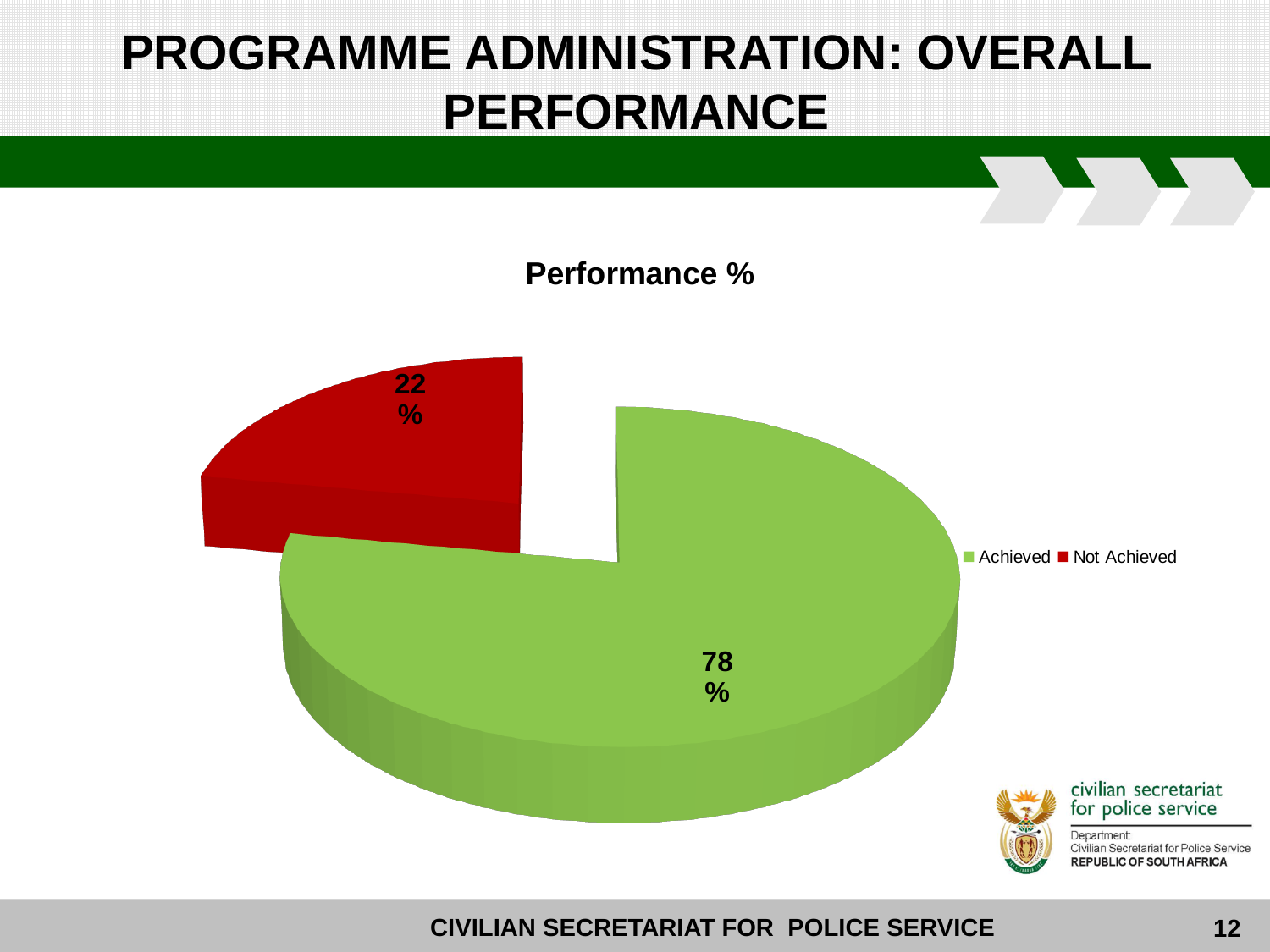
Which is larger, the Achieved slice or the Not Achieved slice? Achieved Which slice of the pie is the largest? Achieved What type of chart is shown on the slide? pie chart What percentage of the pie is labelled Achieved? 78% What is the difference in percentage points between the Achieved and Not Achieved slices? 56 How many entries does the legend list? 2 How many slices does the pie chart have? 2 What is the title of the chart? Performance % What percentage of the pie is labelled Not Achieved? 22% What colour is the Not Achieved slice? red Which slice of the pie is the smallest? Not Achieved What is the total of the two slice percentages shown? 100%